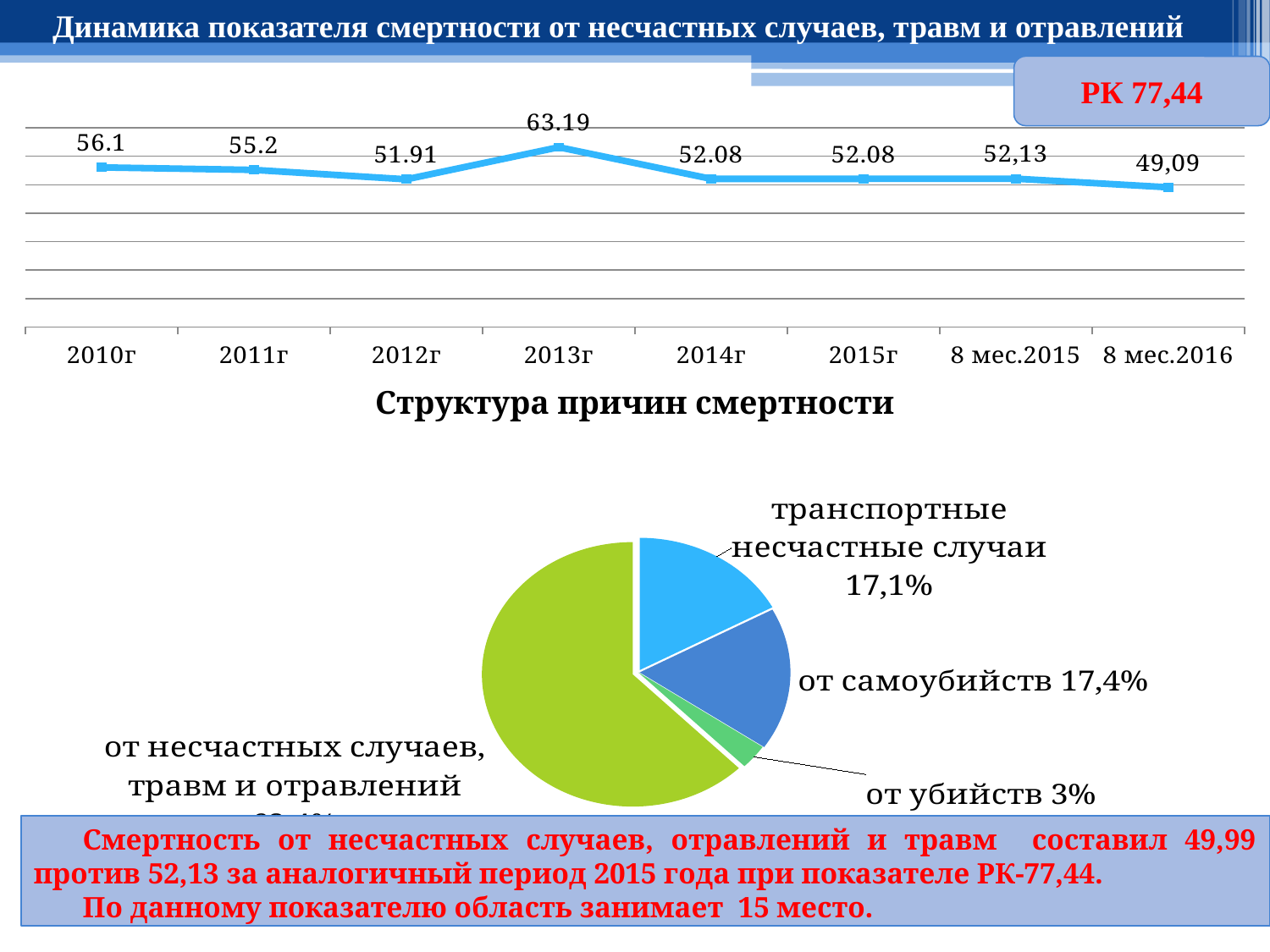
On the line chart at the top, what is the value for 8 мес.2016? 49,09 On the line chart at the top, which period has the highest value? 2013г On the pie chart 'Структура причин смертности', what share is 'от убийств'? 3% On the line chart at the top, which is larger: the value for 2012г or the value for 2013г? 2013г On the line chart at the top, what is the value for 2010г? 56.1 On the pie chart 'Структура причин смертности', what share is 'от самоубийств'? 17,4% On the line chart at the top, which period has the lowest value? 8 мес.2016 On the line chart at the top, does the value rise or fall from 8 мес.2015 to 8 мес.2016? fall How many periods are plotted on the line chart at the top? 8 On the line chart at the top, what is the value for 2013г? 63.19 What kind of chart is the top chart titled 'Динамика показателя смертности от несчастных случаев, травм и отравлений'? line chart On the line chart at the top, what is the difference between the values for 2010г and 2011г? 0.9